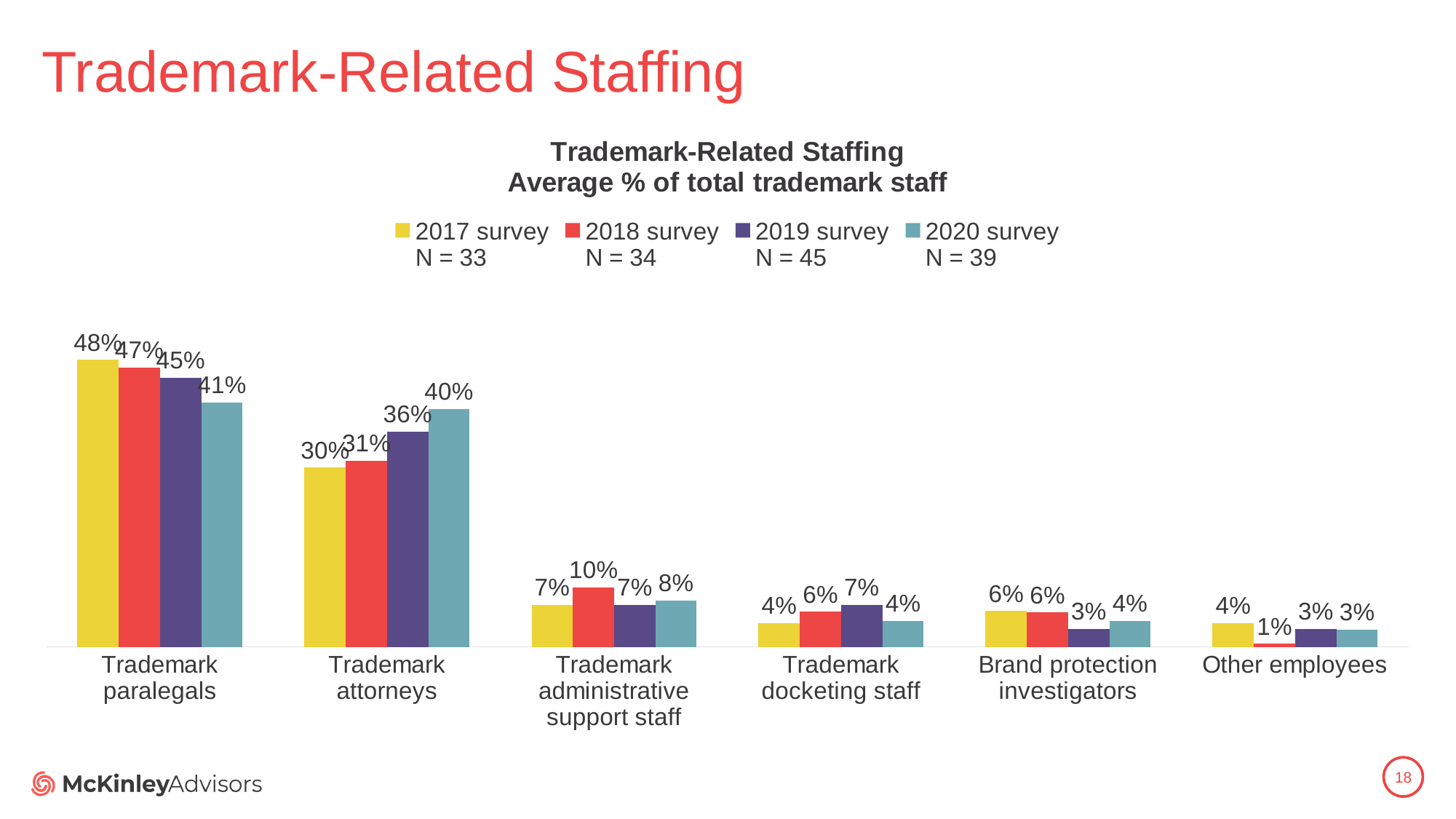
What is the value for Other employees in the 2018 survey? 1% Which is larger for Trademark docketing staff: the 2019 survey value or the 2020 survey value? 2019 survey How many series does the legend list? 4 What is the value for Trademark administrative support staff in the 2018 survey? 10% What is the difference between the 2017 survey and 2020 survey values for Trademark paralegals? 7% Which category has the highest value in the 2020 survey? Trademark paralegals How many categories are shown on the x axis? 6 Which category has the lowest value in the 2018 survey? Other employees What is the value for Trademark paralegals in the 2017 survey? 48% Do the values for Trademark attorneys rise or fall from the 2017 survey to the 2020 survey? Rise What kind of chart is shown on the slide? Bar chart What is the value for Trademark attorneys in the 2020 survey? 40%